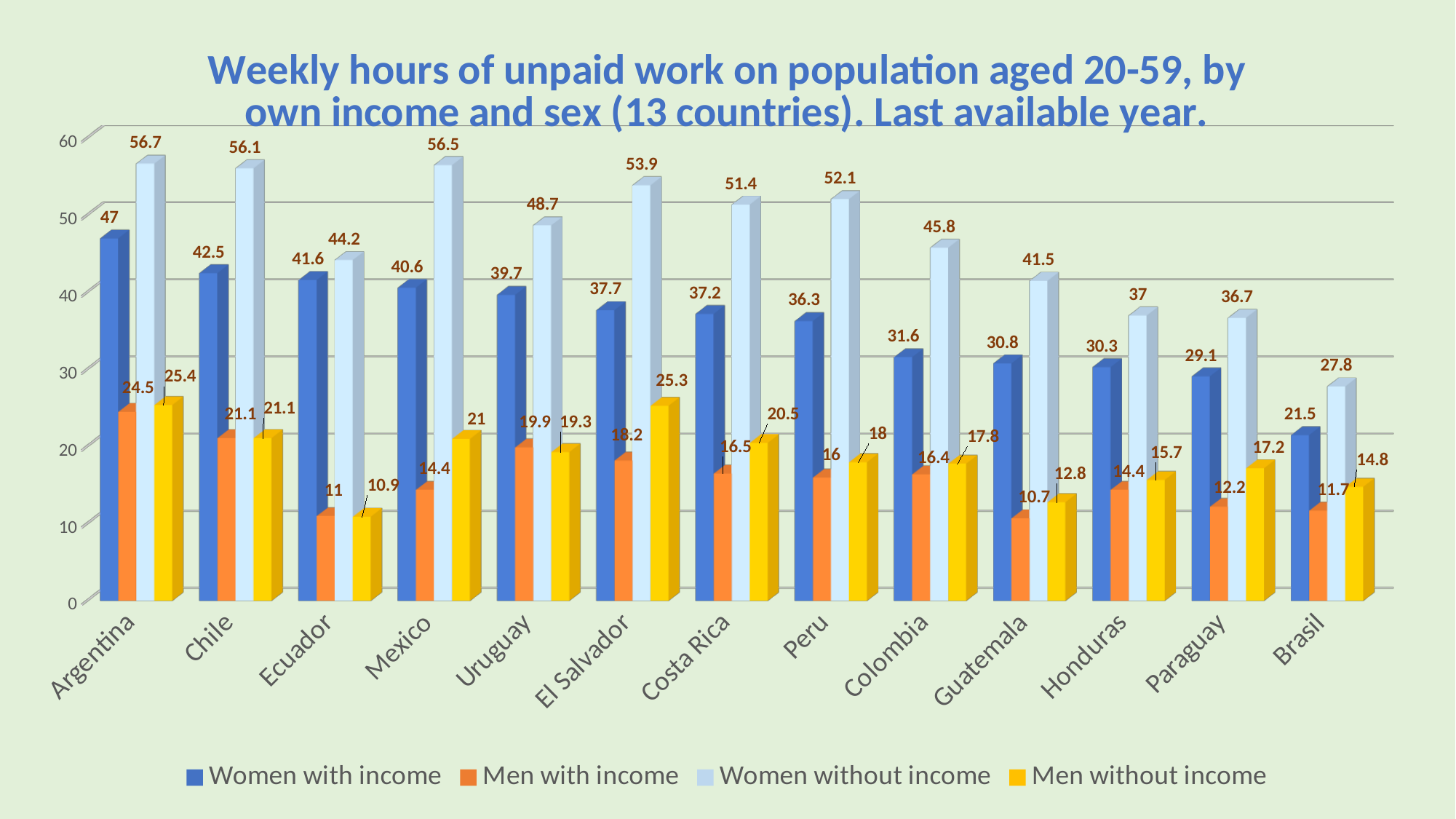
What is the value for Men with income in Paraguay? 12.2 What is the value for Women with income in Argentina? 47 What is the difference between Women without income and Women with income in Mexico? 15.9 Which country has the highest value for Women without income? Argentina Do the values for Women with income rise or fall from Argentina to Brasil along the x axis? Fall How many series does the legend list? 4 What is the value for Women without income in Peru? 52.1 How many countries are shown on the x axis? 13 Which is larger in Uruguay: Men with income or Men without income? Men with income What kind of chart is shown on the slide? Bar chart Which country has the lowest value for Women with income? Brasil What is the value for Men without income in El Salvador? 25.3